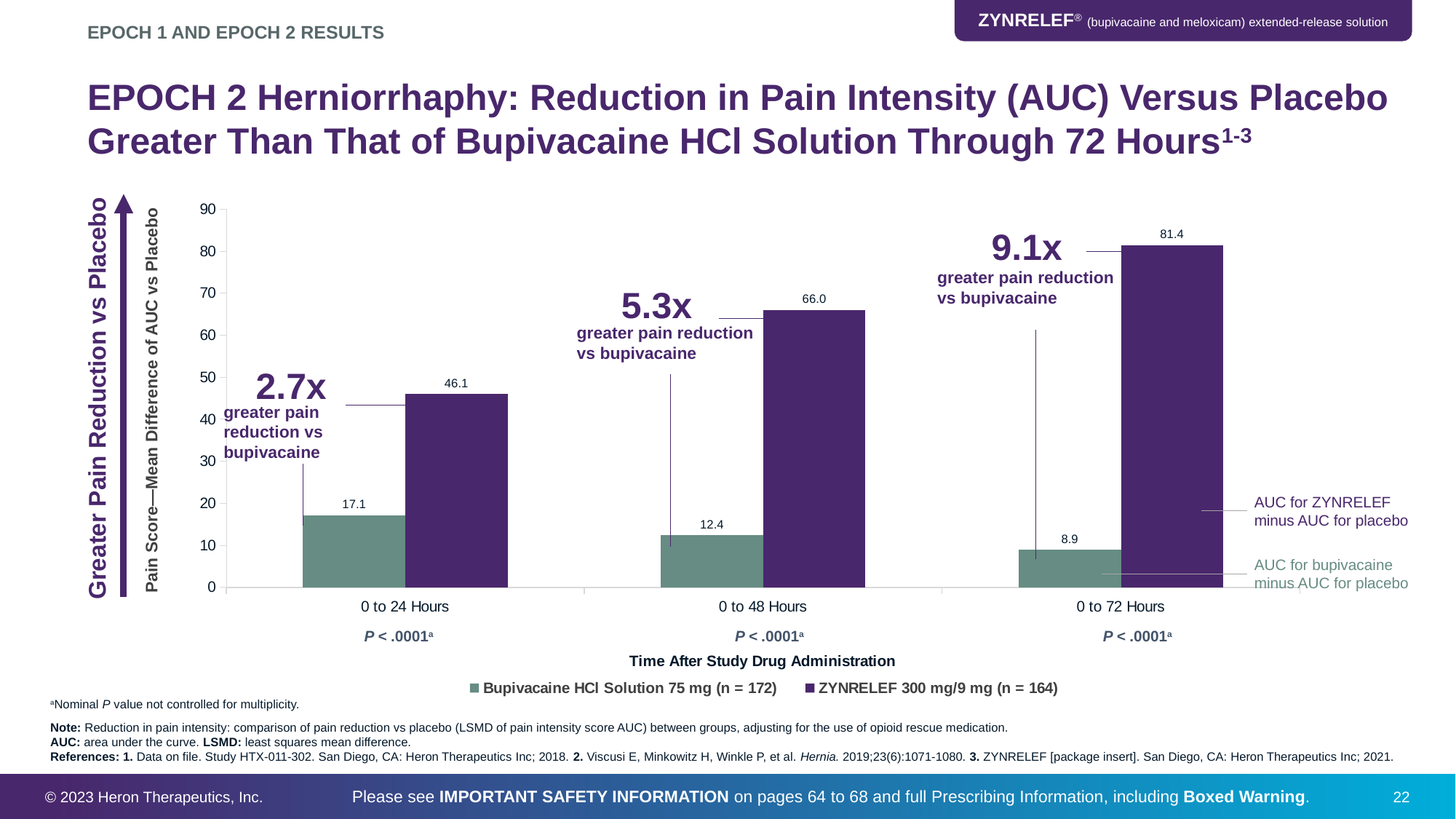
At which time interval is the ZYNRELEF 300 mg/9 mg value highest? 0 to 72 Hours What is the value for Bupivacaine HCl Solution 75 mg at 0 to 48 Hours? 12.4 How many series does the legend list? 2 How many time intervals are shown on the x axis? 3 What is the value for Bupivacaine HCl Solution 75 mg at 0 to 24 Hours? 17.1 What is the difference between the ZYNRELEF and Bupivacaine HCl Solution values at 0 to 24 Hours? 29.0 Which is larger at 0 to 48 Hours: the ZYNRELEF value or the Bupivacaine HCl Solution value? ZYNRELEF 300 mg/9 mg What is the value for ZYNRELEF 300 mg/9 mg at 0 to 48 Hours? 66.0 What kind of chart is shown on the slide? Bar chart At which time interval is the Bupivacaine HCl Solution 75 mg value lowest? 0 to 72 Hours What is the value for ZYNRELEF 300 mg/9 mg at 0 to 72 Hours? 81.4 Do the ZYNRELEF 300 mg/9 mg values rise or fall from 0 to 24 Hours to 0 to 72 Hours? Rise